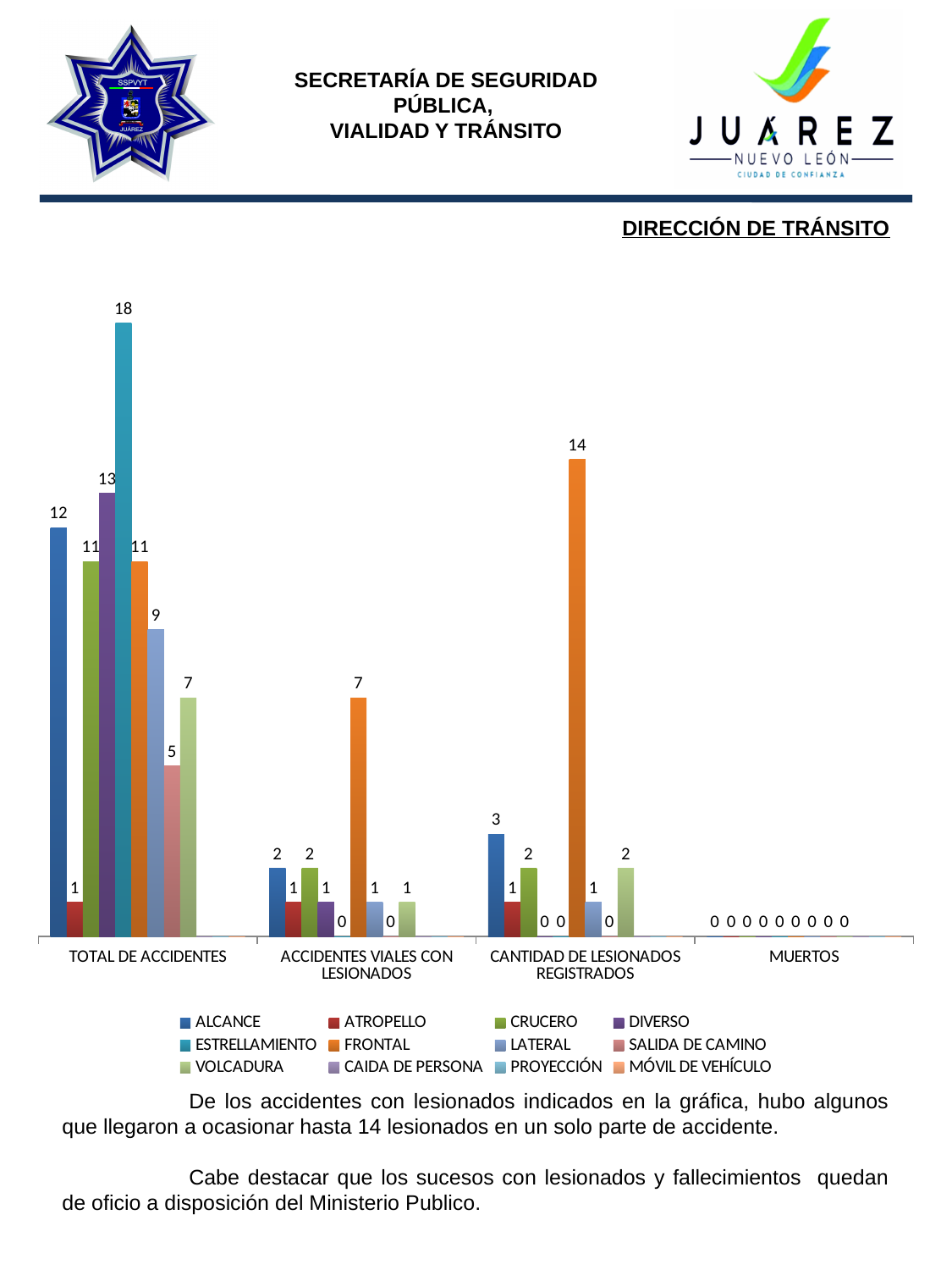
What is the value for SALIDA DE CAMINO in the TOTAL DE ACCIDENTES category? 5 What is the value for FRONTAL in the ACCIDENTES VIALES CON LESIONADOS category? 7 How many series does the legend list? 12 What is the value for ALCANCE in the CANTIDAD DE LESIONADOS REGISTRADOS category? 3 What kind of chart is shown on the slide? Bar chart In the TOTAL DE ACCIDENTES category, which is larger: DIVERSO or CRUCERO? DIVERSO How many categories are shown on the x axis of the chart? 4 What is the value for FRONTAL in the CANTIDAD DE LESIONADOS REGISTRADOS category? 14 Which series has the highest value in the TOTAL DE ACCIDENTES category? ESTRELLAMIENTO Which series has the highest value in the CANTIDAD DE LESIONADOS REGISTRADOS category? FRONTAL What is the value for ESTRELLAMIENTO in the TOTAL DE ACCIDENTES category? 18 In the TOTAL DE ACCIDENTES category, what is the difference between the ESTRELLAMIENTO value and the ALCANCE value? 6